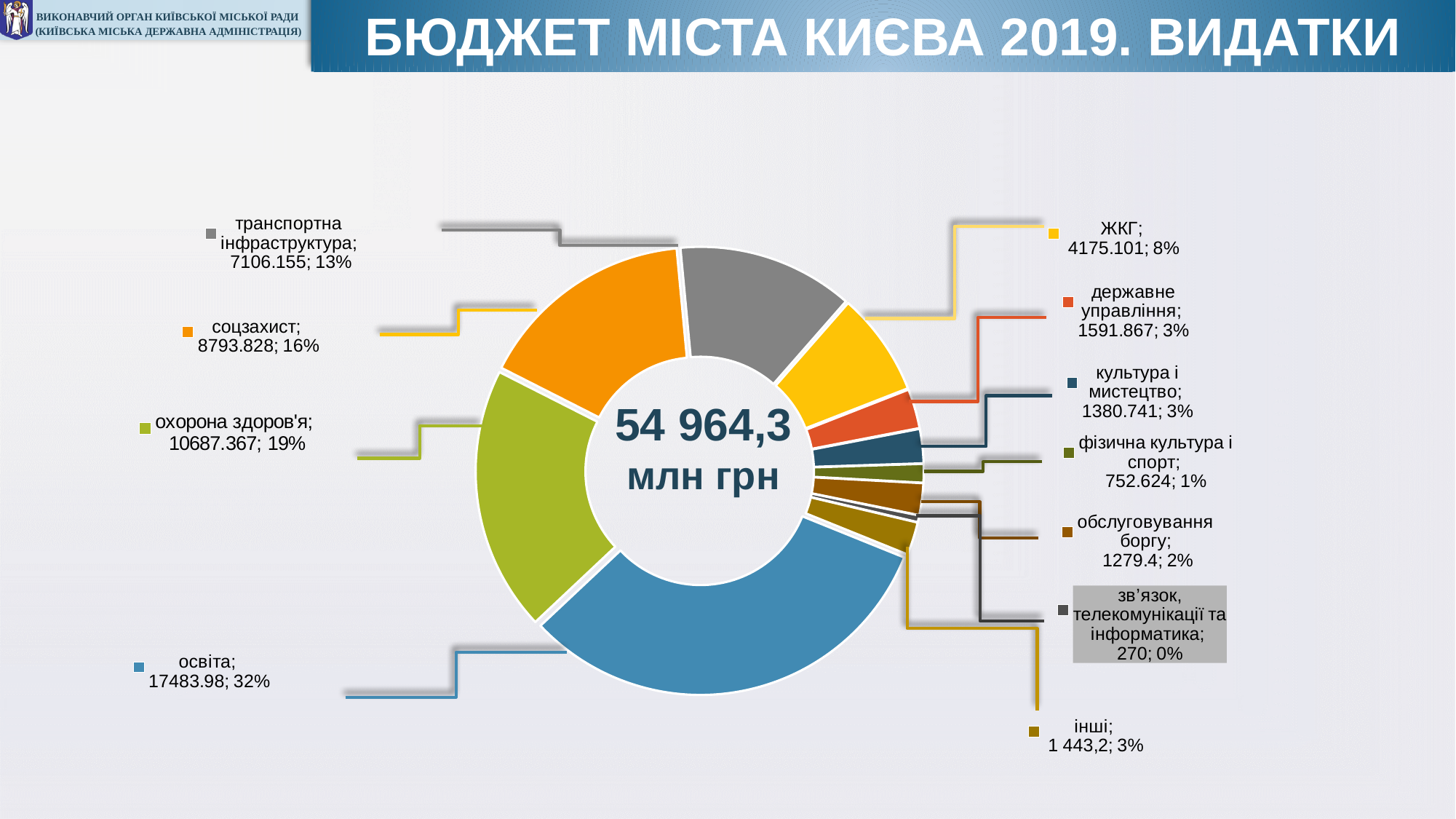
What is the difference between the values for освіта and охорона здоров'я? 6796.613 What is the value shown for освіта? 17483.98 Which category has the smallest share of the chart? зв'язок, телекомунікації та інформатика Which category has the largest share of the chart? освіта What share of the chart does транспортна інфраструктура represent? 13% Which is larger, соцзахист or транспортна інфраструктура? соцзахист What total is shown in the centre of the chart? 54 964,3 млн грн What kind of chart is shown on the slide? pie chart (doughnut) What share of the chart does соцзахист represent? 16% What is the value shown for ЖКГ? 4175.101 What is the value shown for охорона здоров'я? 10687.367 How many categories does the chart show? 11